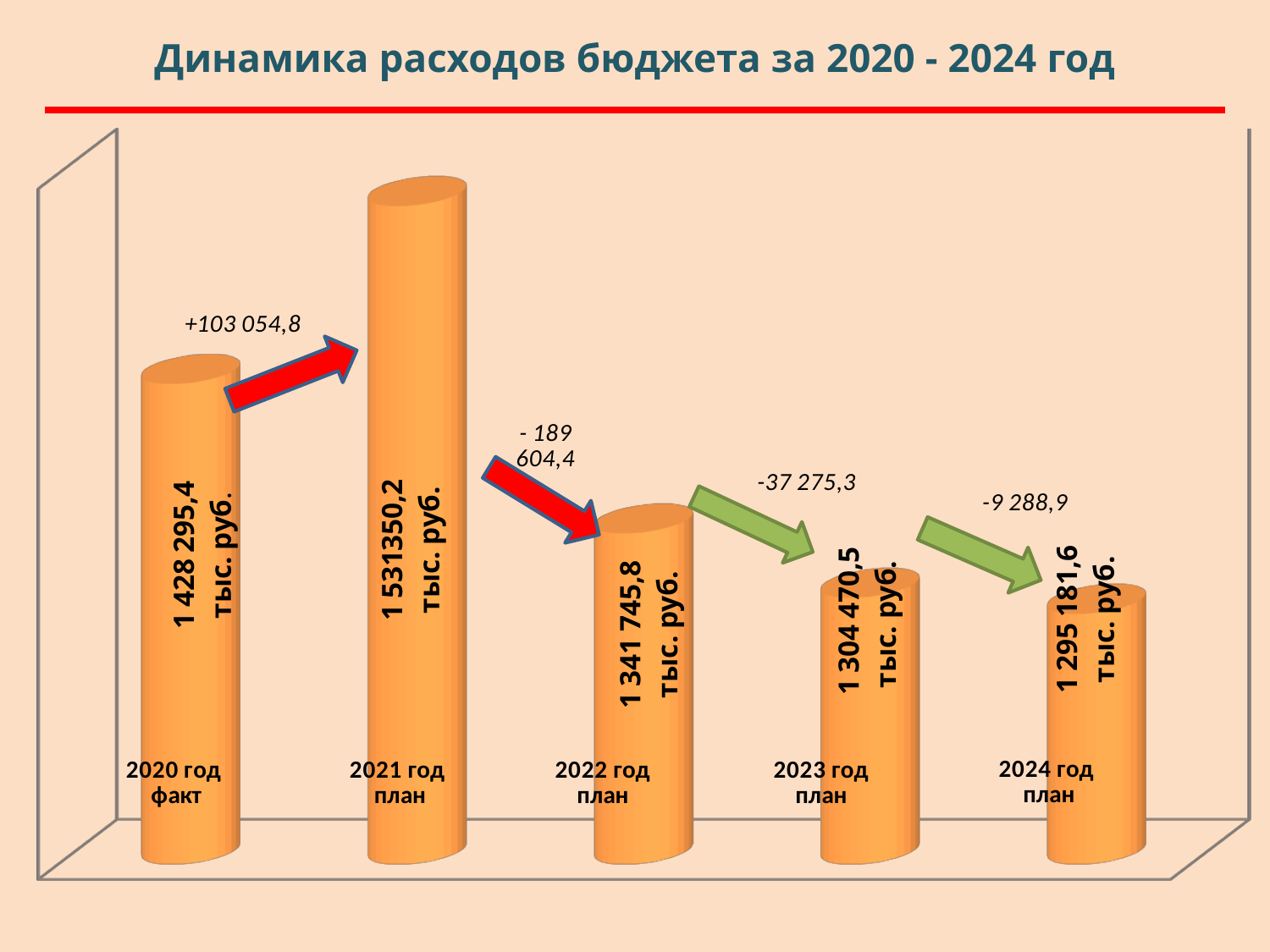
What is the value shown for 2022 год план? 1 341 745,8 тыс. руб. What is the budget expenditure value shown for 2020 год факт? 1 428 295,4 тыс. руб. Which year has the highest budget expenditure value? 2021 год план How many years (categories) are shown on the chart? 5 Which year has the lowest budget expenditure value? 2024 год план What is the value shown for 2021 год план? 1 531 350,2 тыс. руб. What change is shown by the arrow between 2020 год факт and 2021 год план? +103 054,8 What kind of chart is shown on the slide? Bar chart What change is shown by the arrow between 2021 год план and 2022 год план? - 189 604,4 Which is larger, the value for 2022 год план or the value for 2023 год план? 2022 год план What change is shown by the arrow between 2023 год план and 2024 год план? -9 288,9 What is the value shown for 2024 год план? 1 295 181,6 тыс. руб.